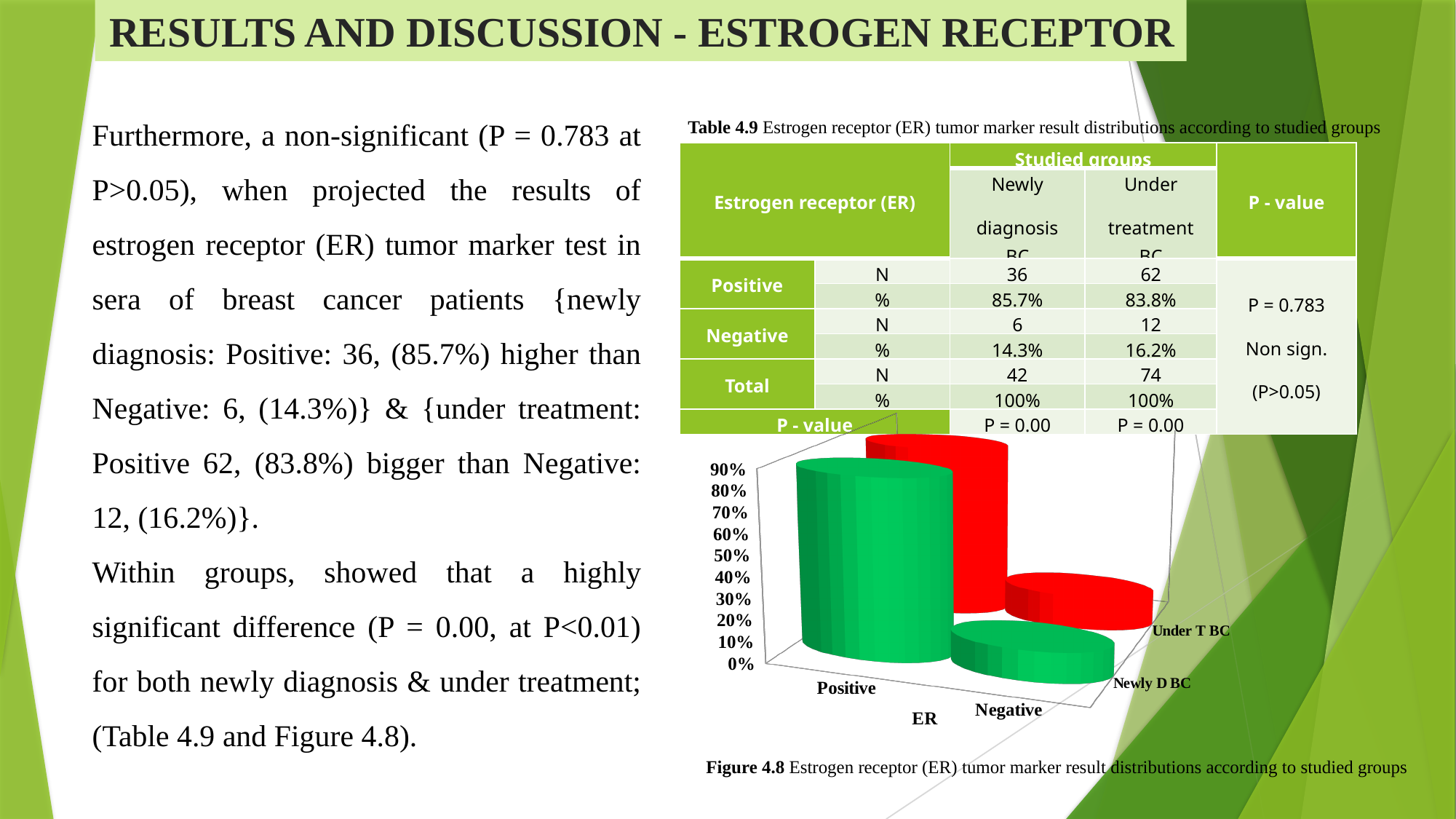
What is the title of the horizontal axis in the chart in Figure 4.8? ER In the chart in Figure 4.8, is the Newly D BC value for Negative greater or less than 40%? less In the chart in Figure 4.8, which ER category has the highest value for Newly D BC? Positive In the chart in Figure 4.8, is the Newly D BC value for Positive greater or less than 50%? greater In the chart in Figure 4.8, do the values rise or fall going from Positive to Negative along the ER axis? fall In the chart in Figure 4.8, which is larger for Under T BC: Positive or Negative? Positive What kind of chart is Figure 4.8? bar chart How many studied groups (series) are plotted in the chart in Figure 4.8? 2 How many categories are shown on the ER axis of the chart in Figure 4.8? 2 In the chart in Figure 4.8, which ER category has the lowest value for Under T BC? Negative What colour are the Newly D BC bars in the chart in Figure 4.8? green